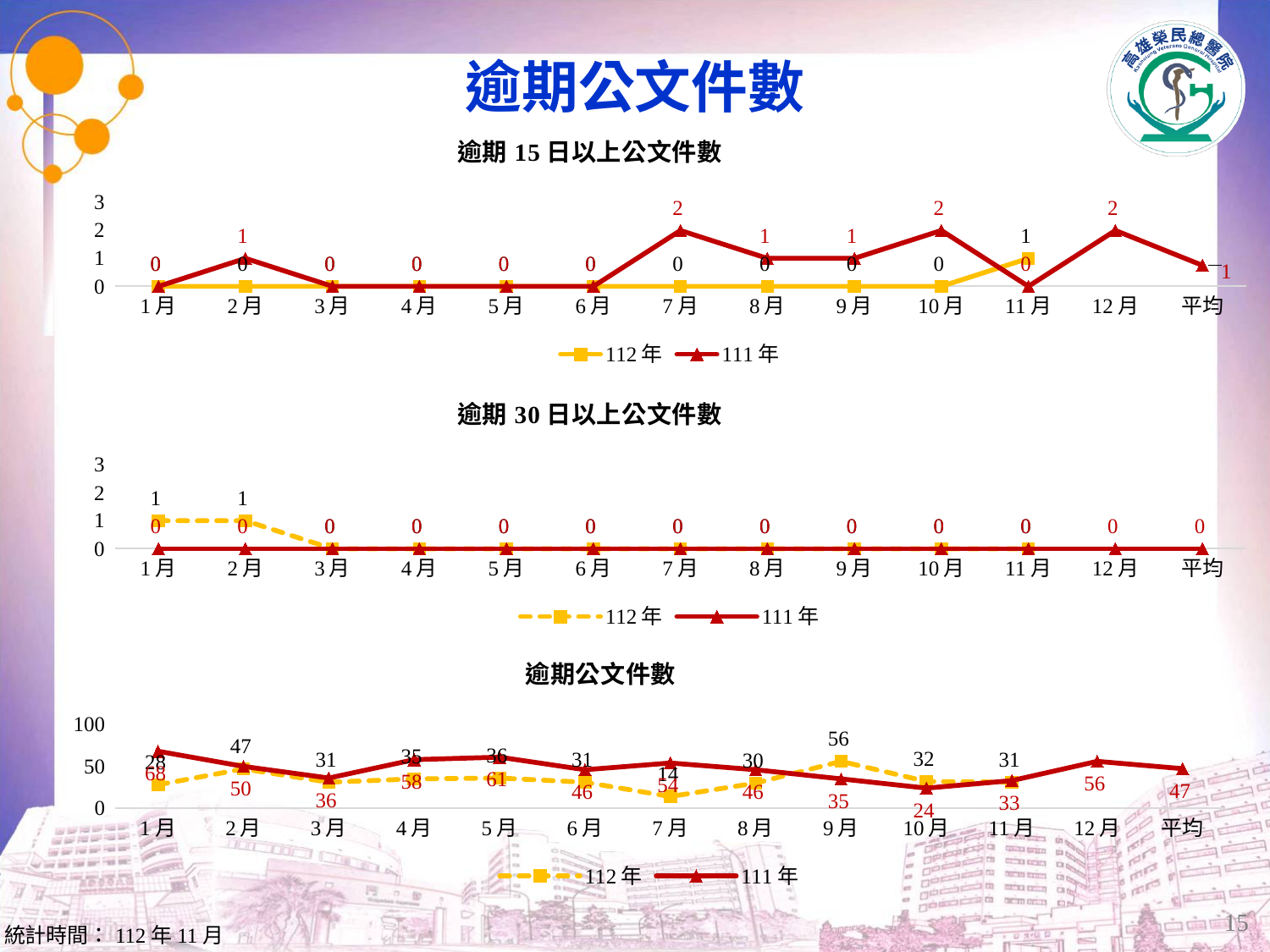
In the bottom chart titled 逾期公文件數, in which month is the 111年 value lowest? 10月 In the bottom chart titled 逾期公文件數, what is the value for 112年 in 9月? 56 In the bottom chart titled 逾期公文件數, how much higher is the 111年 value than the 112年 value in 1月? 40 In the top chart titled 逾期15日以上公文件數, what is the 平均 value for 111年? 1 In the bottom chart titled 逾期公文件數, in which month is the 112年 value lowest? 7月 In the bottom chart titled 逾期公文件數, what is the 平均 value for 111年? 47 In the bottom chart titled 逾期公文件數, in which month is the 112年 value highest? 9月 In the top chart titled 逾期15日以上公文件數, in how many months does the 111年 series reach a value of 2? 3 In the bottom chart titled 逾期公文件數, what is the value for 111年 in 1月? 68 In the top chart titled 逾期15日以上公文件數, what is the value for 112年 in 11月? 1 What kind of chart is the middle chart titled 逾期30日以上公文件數? Line chart In the bottom chart titled 逾期公文件數, which series has the larger value in 9月, 112年 or 111年? 112年